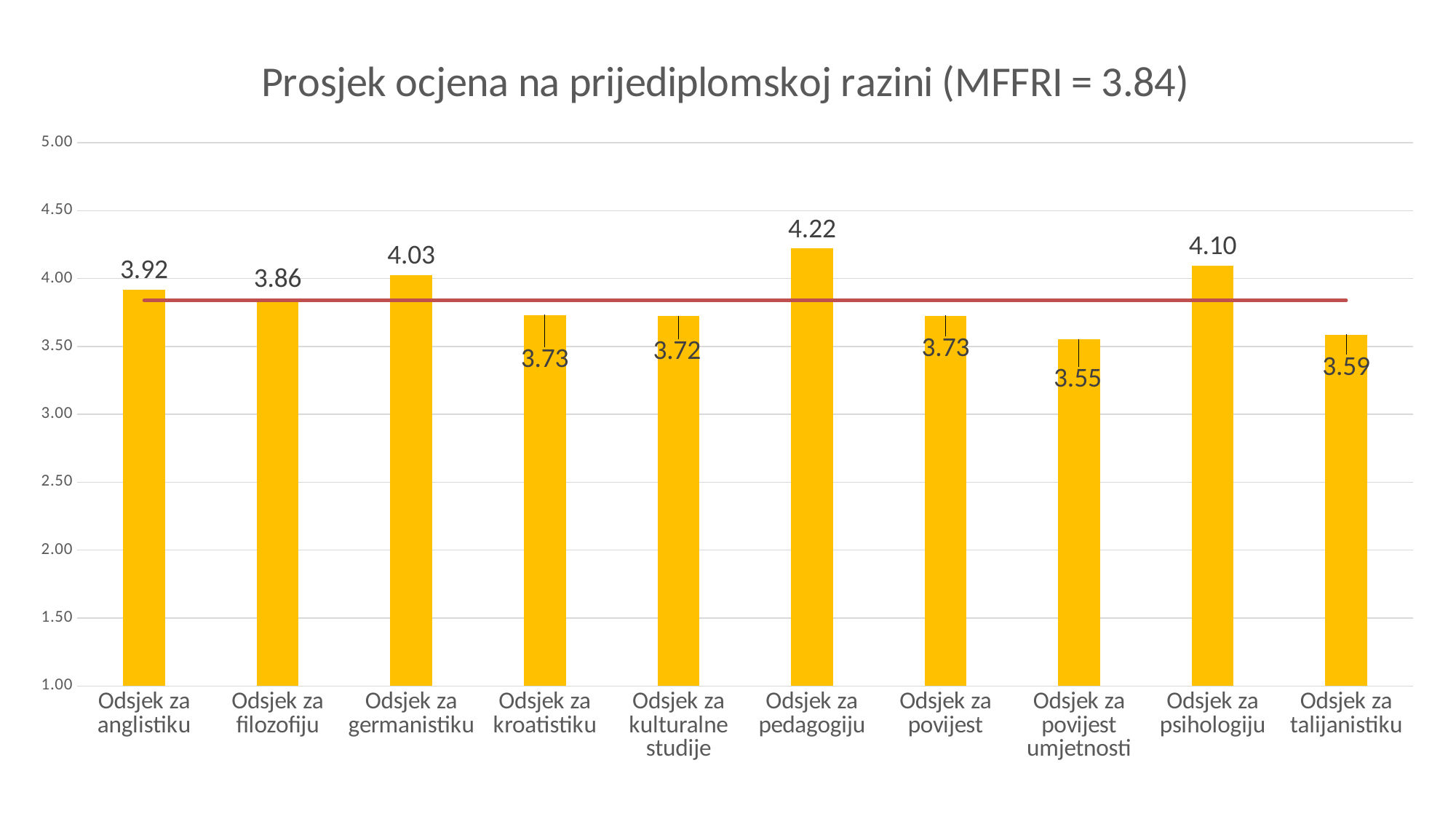
What colour are the bars on the chart? yellow Which department has the lowest average grade? Odsjek za povijest umjetnosti What is the value for Odsjek za talijanistiku? 3.59 What is the value for Odsjek za kulturalne studije? 3.72 What is the value for Odsjek za pedagogiju? 4.22 What kind of chart is this? bar chart Which department has the highest average grade? Odsjek za pedagogiju Is the value for Odsjek za anglistiku greater or less than 3.50? greater What is the title of the chart? Prosjek ocjena na prijediplomskoj razini (MFFRI = 3.84) How many departments are shown on the chart? 10 What is the difference between the values for Odsjek za pedagogiju and Odsjek za povijest umjetnosti? 0.67 Which is larger, the value for Odsjek za germanistiku or Odsjek za psihologiju? Odsjek za psihologiju